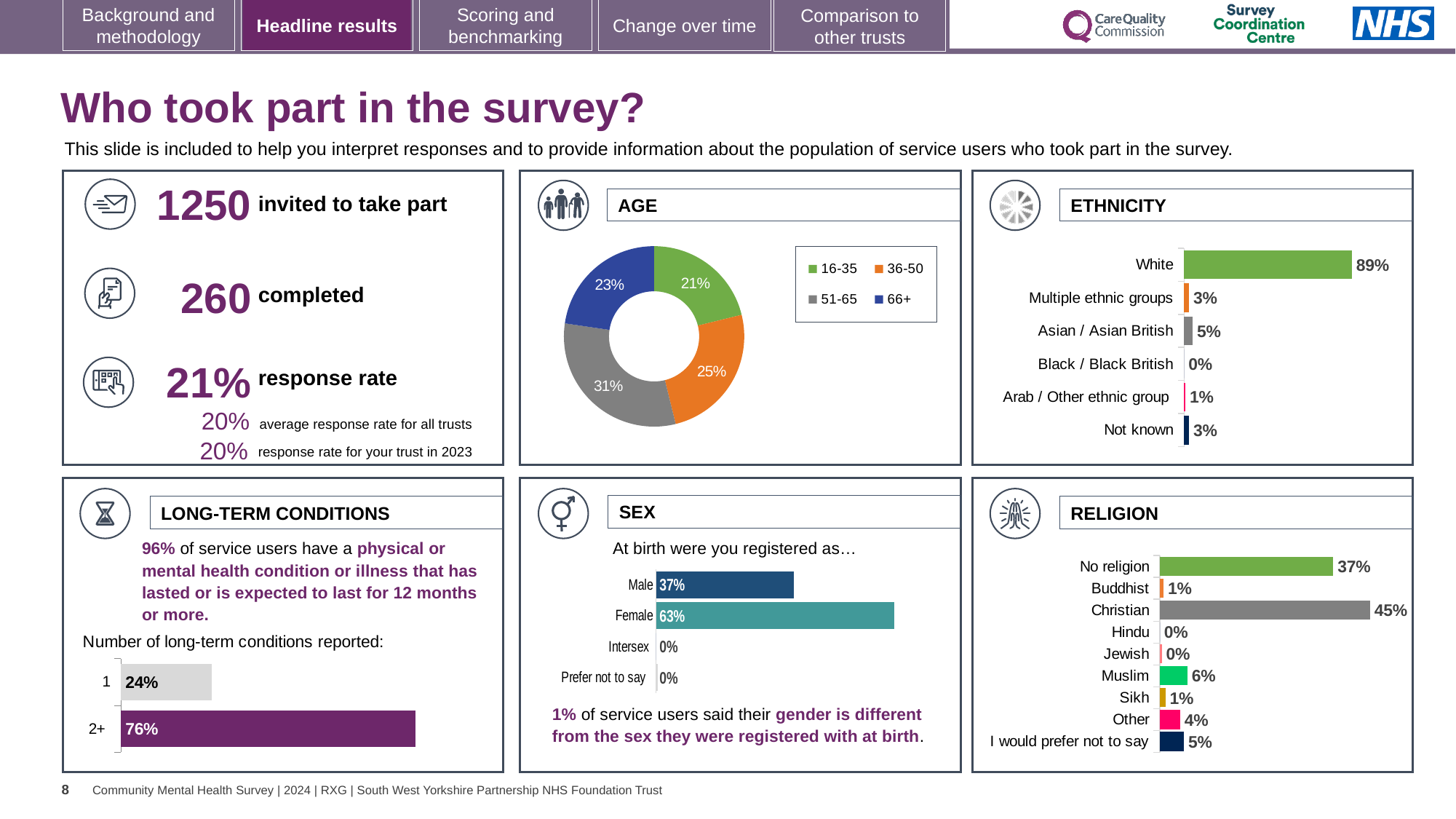
In the ETHNICITY chart, which category has the highest value? White In the SEX chart, which is larger, the value for Male or Female? Female In the RELIGION chart, which category has the highest value? Christian In the ETHNICITY chart, what is the value for Asian / Asian British? 5% In the SEX chart, what is the value for Male? 37% In the AGE chart, what share of respondents were aged 51-65? 31% In the LONG-TERM CONDITIONS chart, what is the difference between the values for 2+ and 1? 52% How many entries does the legend of the AGE chart list? 4 What kind of chart is the AGE chart? Donut chart In the ETHNICITY chart, how many categories are shown? 6 In the AGE chart, which age group has the smallest share? 16-35 In the RELIGION chart, what is the value for Muslim? 6%